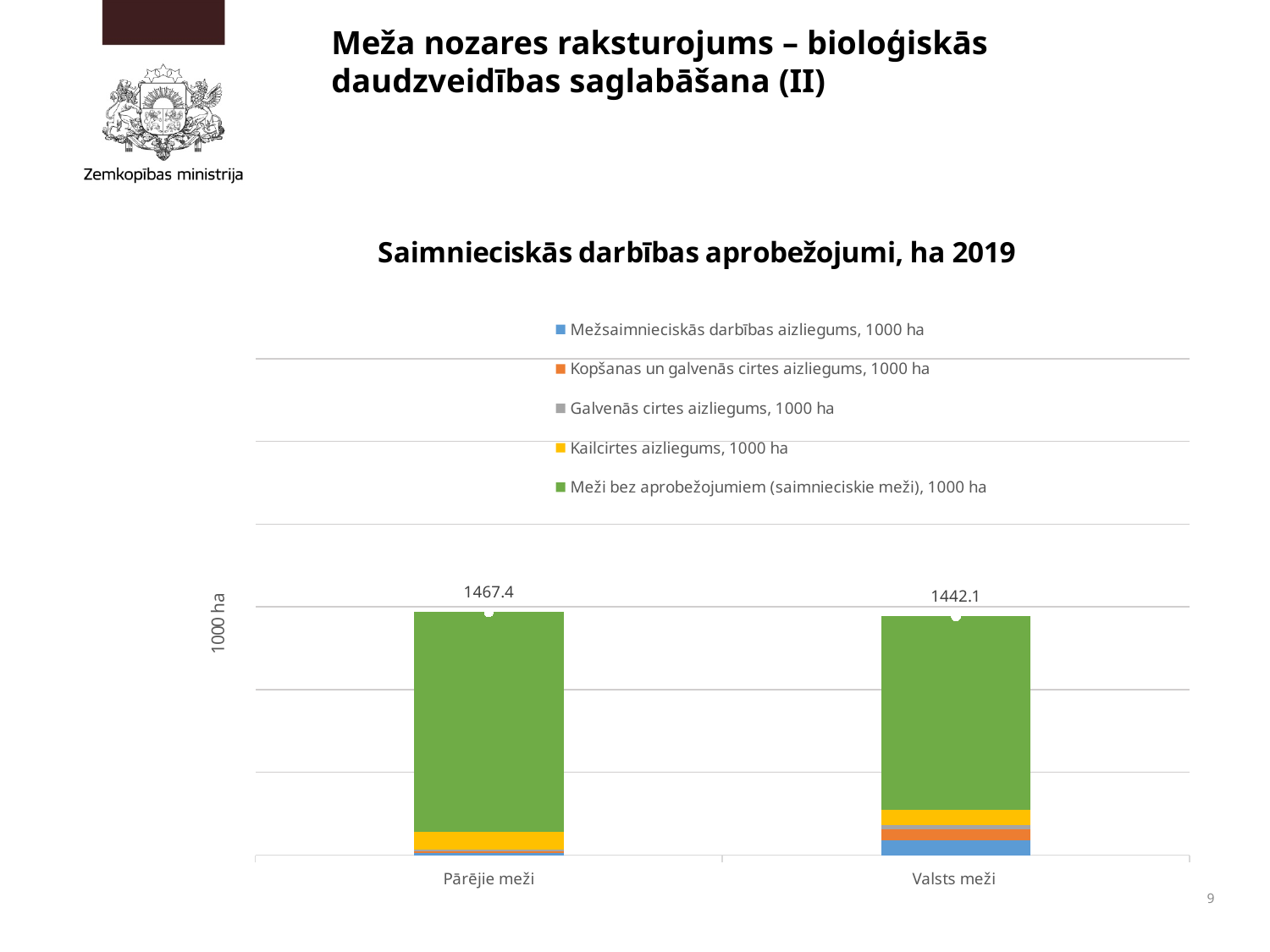
Which category has the larger orange segment (Kopšanas un galvenās cirtes aizliegums, 1000 ha)? Valsts meži Which category has the larger blue segment (Mežsaimnieciskās darbības aizliegums, 1000 ha)? Valsts meži How many series does the chart legend list? 5 What is the difference between the values labelled for Pārējie meži (1467.4) and Valsts meži (1442.1)? 25.3 Which category has the taller bar, Pārējie meži or Valsts meži? Pārējie meži What is the title of the chart? Saimnieciskās darbības aprobežojumi, ha 2019 Which series is shown in green in the chart? Meži bez aprobežojumiem (saimnieciskie meži), 1000 ha What type of chart is shown on the slide? Stacked bar chart What value is labelled at the top of the Valsts meži bar? 1442.1 How many categories are shown on the x axis of the chart? 2 What value is labelled at the top of the Pārējie meži bar? 1467.4